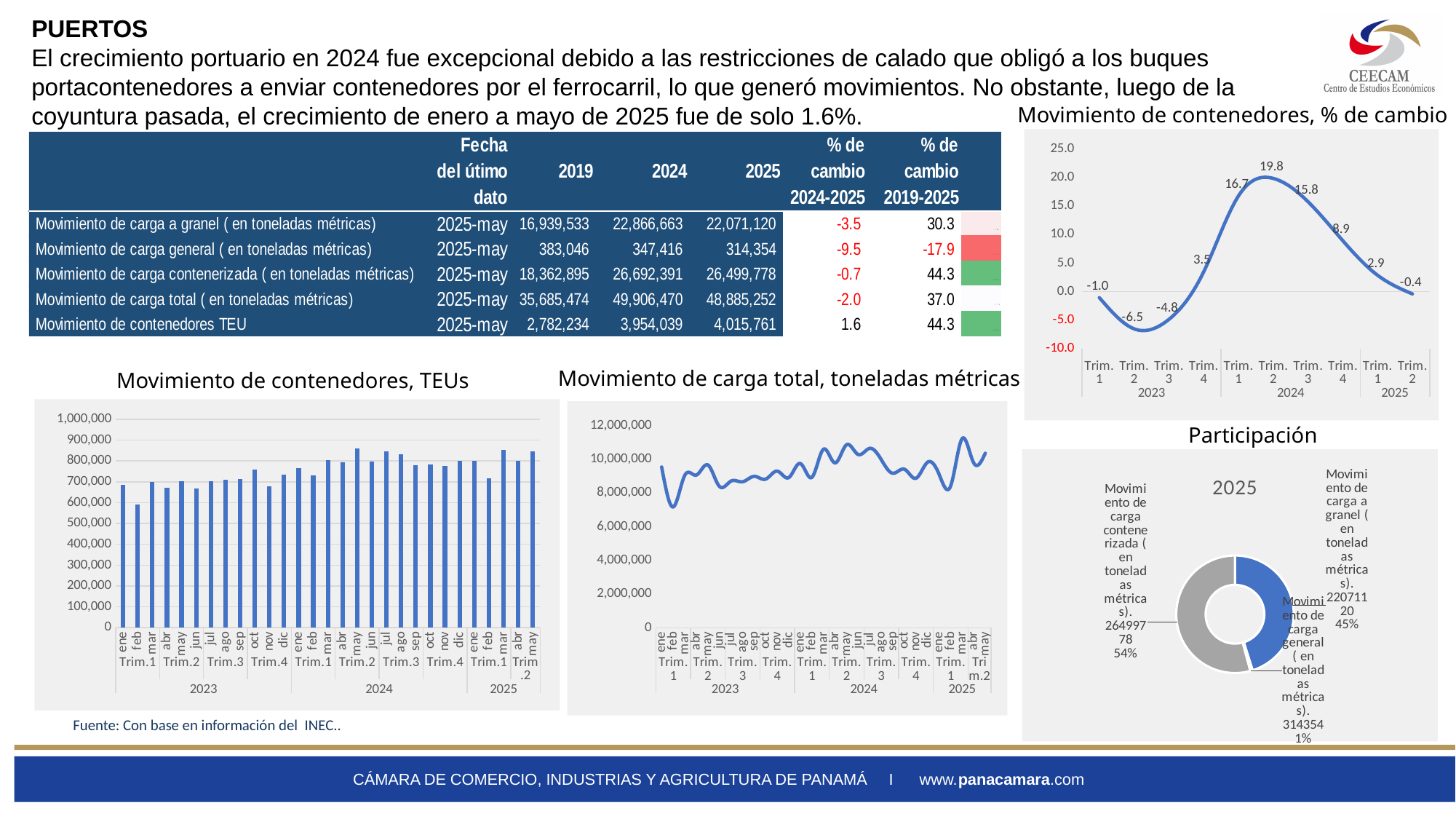
In the 'Movimiento de contenedores, TEUs' chart, is the value for may 2024 greater or less than 800,000? greater In the 'Movimiento de contenedores, % de cambio' chart, do the values rise or fall from Trim. 2 of 2024 to Trim. 2 of 2025? fall In the 'Participación' chart, what share does 'Movimiento de carga contenerizada' have? 54% In the 'Movimiento de contenedores, % de cambio' chart, which quarter has the highest value? Trim. 2 2024 In the 'Movimiento de contenedores, % de cambio' chart, what is the difference between the values for Trim. 1 of 2024 and Trim. 3 of 2024? 0.9 In the 'Movimiento de carga total, toneladas métricas' chart, is the value for feb 2023 greater or less than 8,000,000? less In the 'Movimiento de contenedores, % de cambio' chart, which quarter has the lowest value? Trim. 2 2023 In the 'Movimiento de contenedores, % de cambio' chart, how many quarterly data points are plotted? 10 In the 'Movimiento de contenedores, % de cambio' chart, what is the value for Trim. 2 of 2024? 19.8 In the 'Movimiento de contenedores, % de cambio' chart, what is the value for Trim. 2 of 2023? -6.5 What kind of chart is 'Movimiento de contenedores, TEUs'? bar chart In the 'Participación' chart, what is the value shown for 'Movimiento de carga a granel'? 22071120